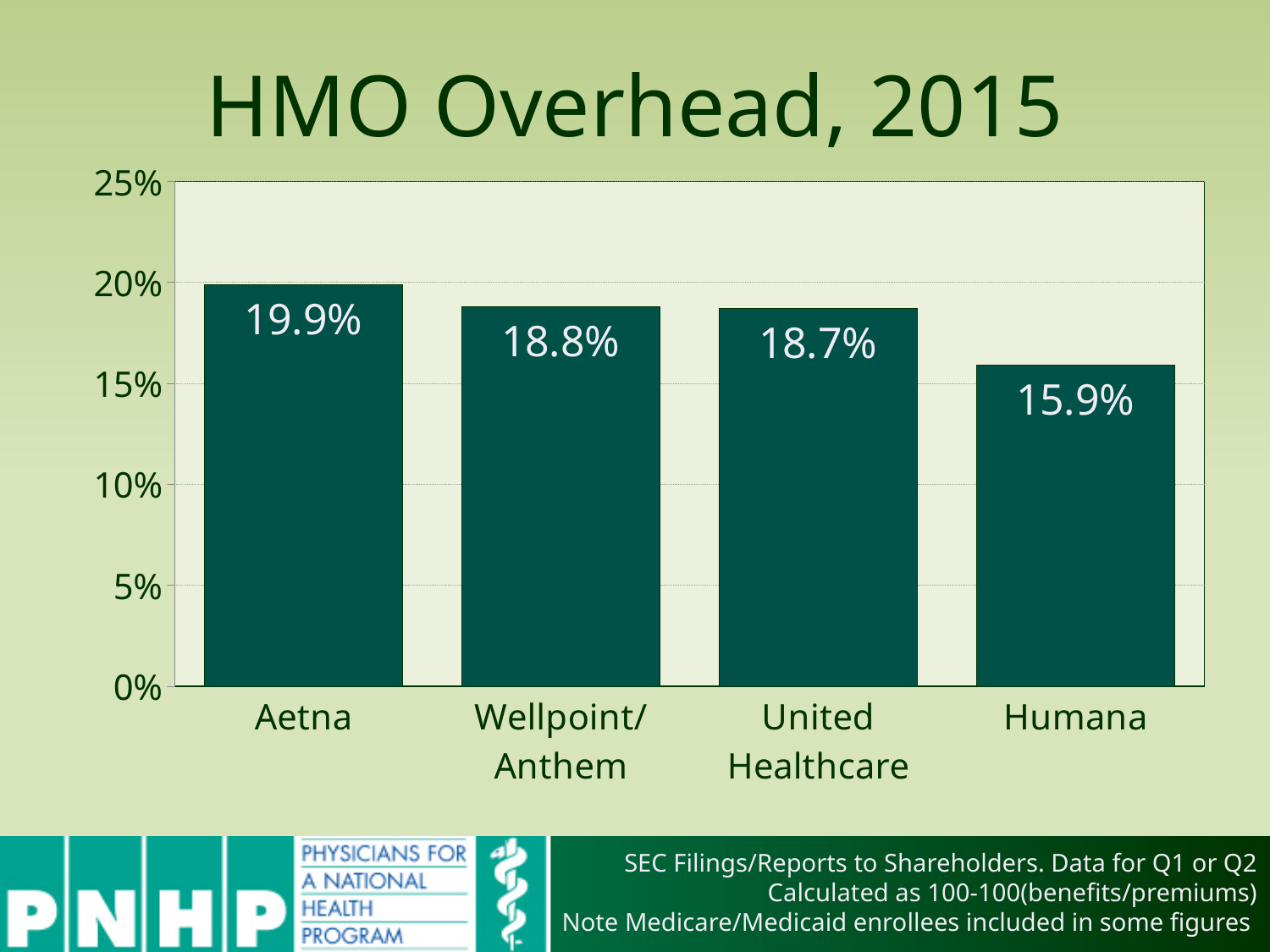
What is the overhead value for United Healthcare? 18.7% Is the value for Humana greater or less than 20%? less What is the overhead value for Aetna? 19.9% What is the overhead value for Humana? 15.9% What is the overhead value for Wellpoint/Anthem? 18.8% Which company has the lowest overhead? Humana Which company has the highest overhead? Aetna What kind of chart is shown on the slide? bar chart Which is larger, the overhead for Aetna or for Humana? Aetna How many companies are shown in the chart? 4 What is the difference between Aetna's and Humana's overhead? 4.0% What is the title of the chart? HMO Overhead, 2015